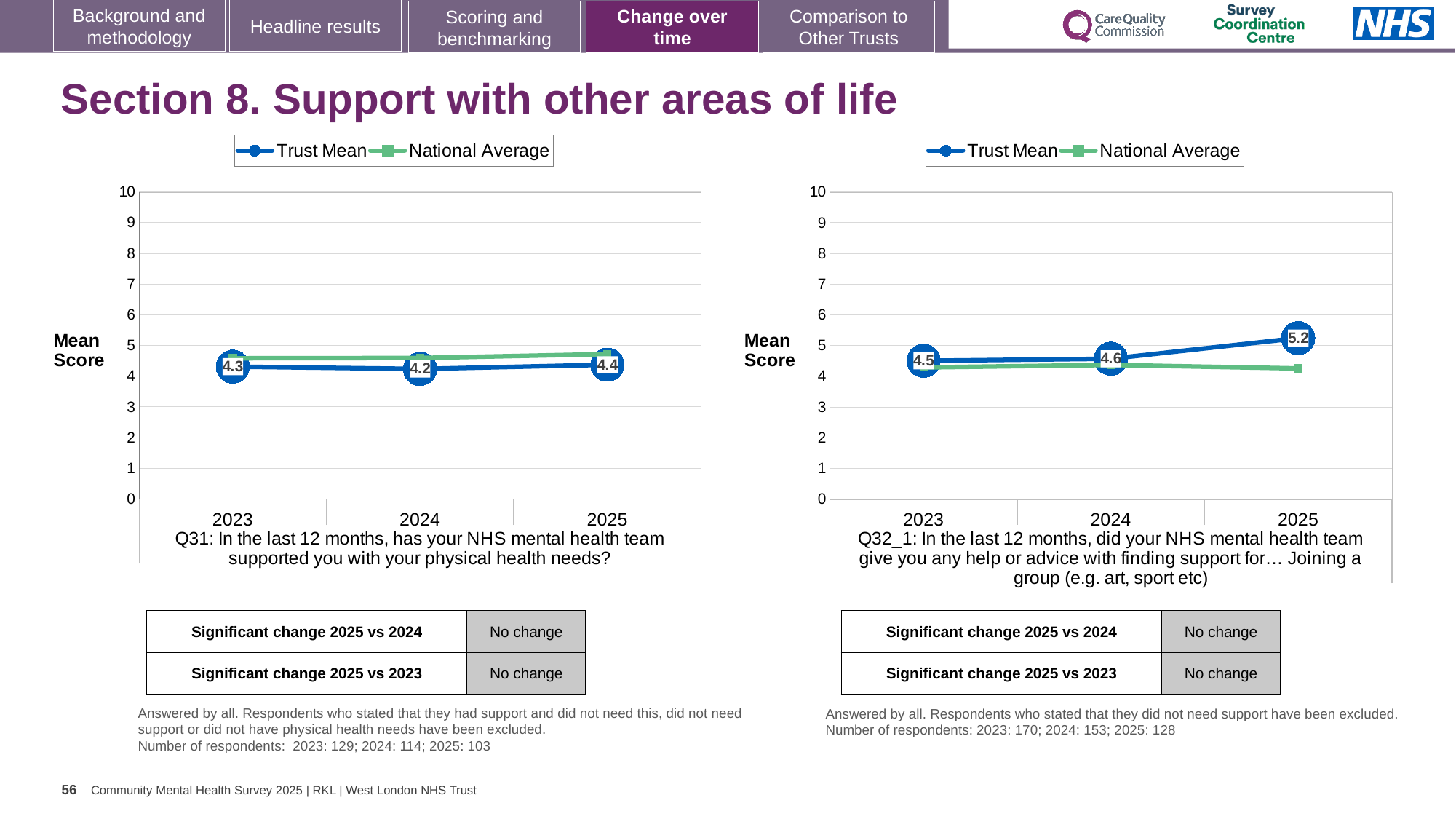
In the Q32_1 chart (right), what is the Trust Mean score for 2025? 5.2 In the Q32_1 chart (right), which year has the highest Trust Mean score? 2025 What kind of chart is used for Q31 (left)? Line chart In the Q31 chart (left), is the Trust Mean score for 2023 or 2025 larger? 2025 In the Q32_1 chart (right), what is the Trust Mean score for 2023? 4.5 In the Q32_1 chart (right), is the National Average for 2025 greater or less than 5? less How many series does the legend of the Q32_1 chart (right) list? 2 In the Q31 chart (left), what is the Trust Mean score for 2024? 4.2 In the Q32_1 chart (right), what is the difference between the Trust Mean scores for 2025 and 2023? 0.7 In the Q31 chart (left), which year has the lowest Trust Mean score? 2024 In the Q31 chart (left), what is the Trust Mean score for 2025? 4.4 How many years are plotted on the x axis of the Q31 chart (left)? 3